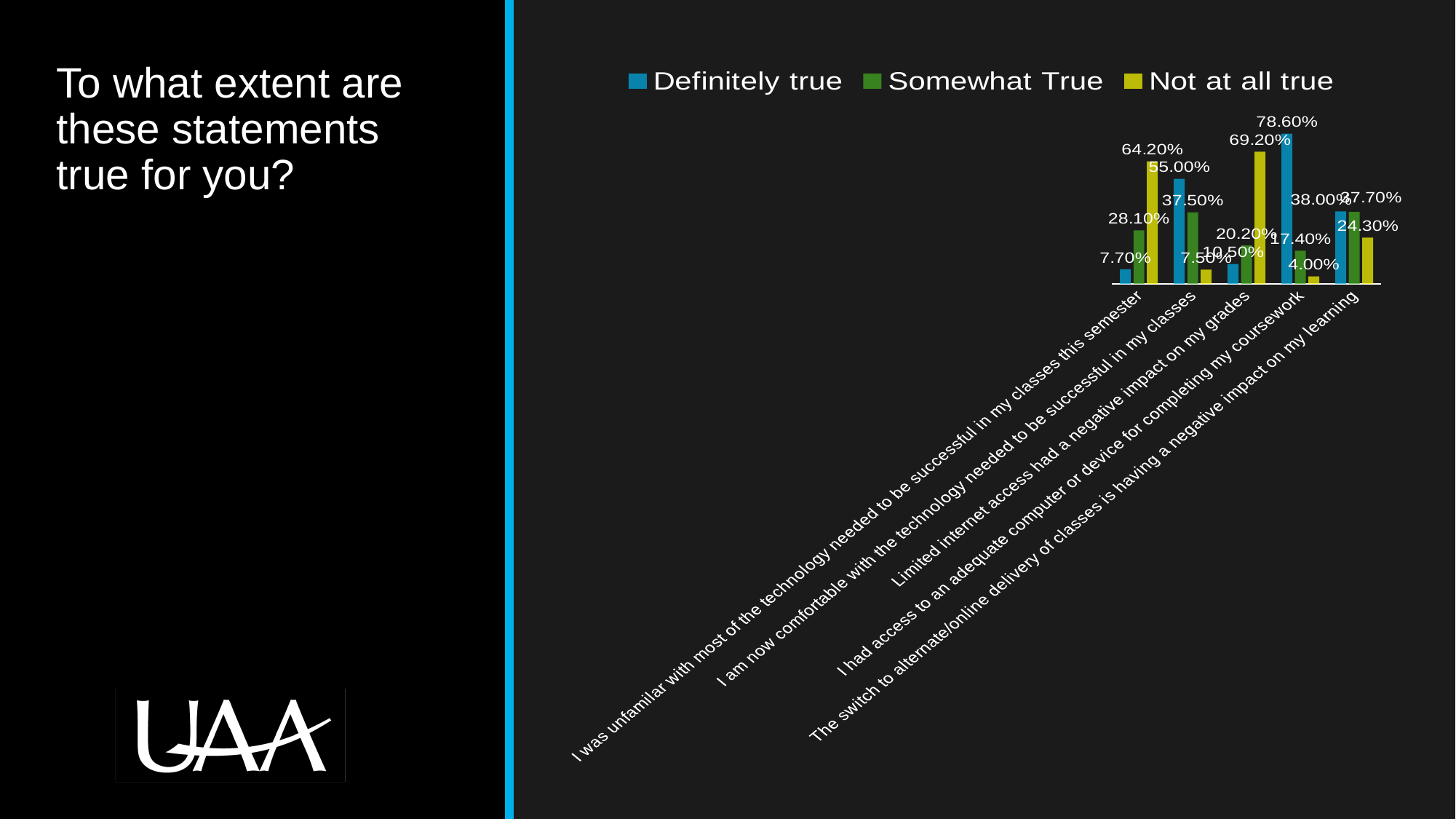
What is the 'Somewhat True' value for 'I was unfamilar with most of the technology needed to be successful in my classes this semester'? 28.10% What is the 'Not at all true' value for 'Limited internet access had a negative impact on my grades'? 69.20% What colour represents the 'Not at all true' series in the legend? yellow What kind of chart is shown on the slide? bar chart Which statement has the lowest 'Not at all true' value? I had access to an adequate computer or device for completing my coursework For 'I am now comfortable with the technology needed to be successful in my classes', which is larger: 'Definitely true' or 'Not at all true'? Definitely true What is the 'Definitely true' value for 'I had access to an adequate computer or device for completing my coursework'? 78.60% For 'I had access to an adequate computer or device for completing my coursework', what is the difference between the 'Definitely true' and 'Somewhat True' values? 61.20% How many series does the legend list? 3 How many statements (categories) are plotted on the x axis? 5 Which statement has the highest 'Definitely true' value? I had access to an adequate computer or device for completing my coursework For 'I was unfamilar with most of the technology needed to be successful in my classes this semester', what is the difference between the 'Not at all true' and 'Definitely true' values? 56.50%